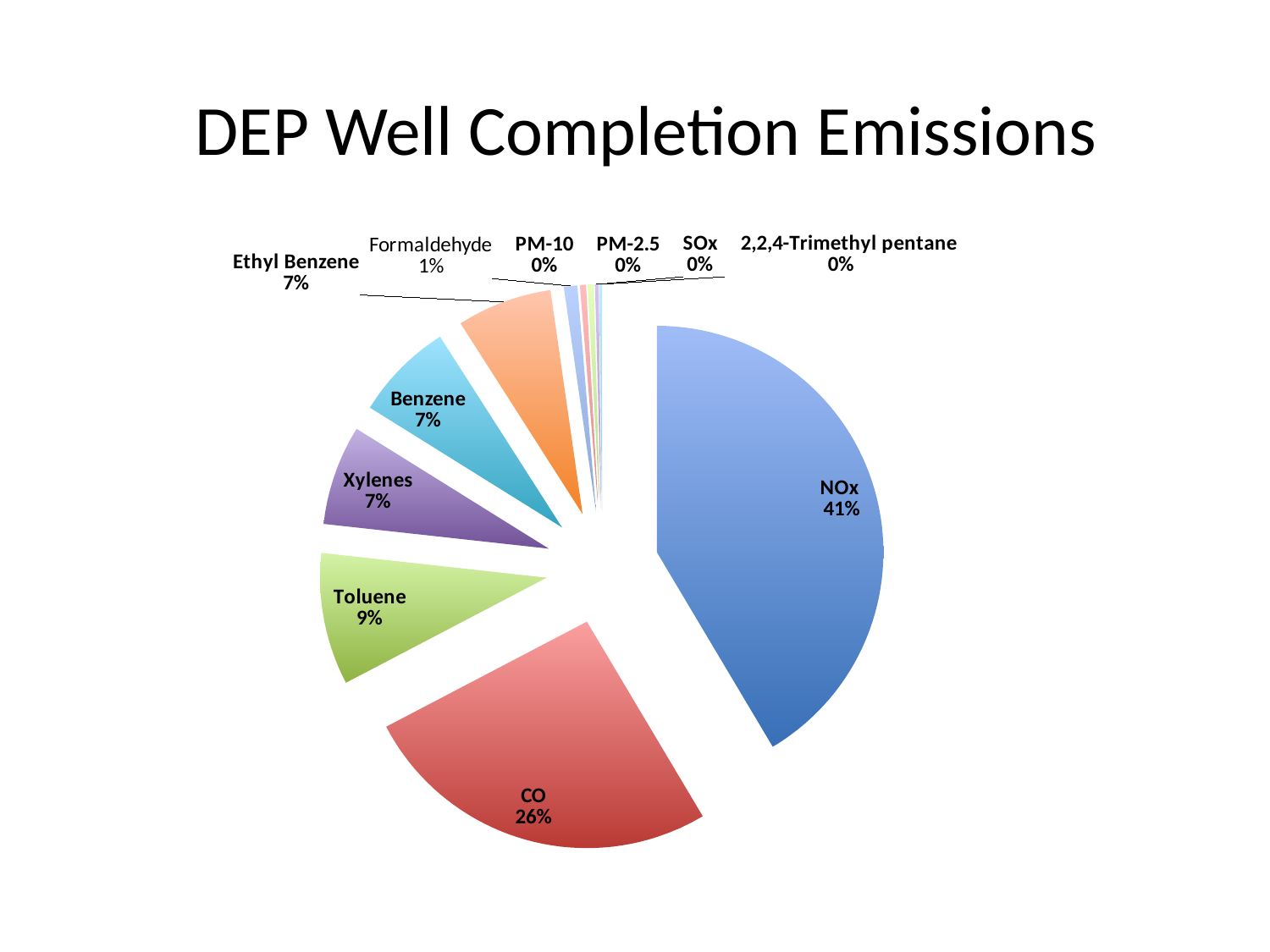
What percentage is shown for Formaldehyde? 1% What is the difference in percentage points between NOx and CO? 15 What share of the pie does NOx account for? 41% What percentage is shown for Xylenes? 7% What share of the pie does CO account for? 26% What percentage is shown for PM-10? 0% What percentage is shown for Toluene? 9% Which is larger, the share for Toluene or the share for Benzene? Toluene Which category has the largest slice of the pie? NOx What is the title of the chart? DEP Well Completion Emissions How many categories are labelled on the pie chart? 11 What kind of chart is shown on the slide? Pie chart